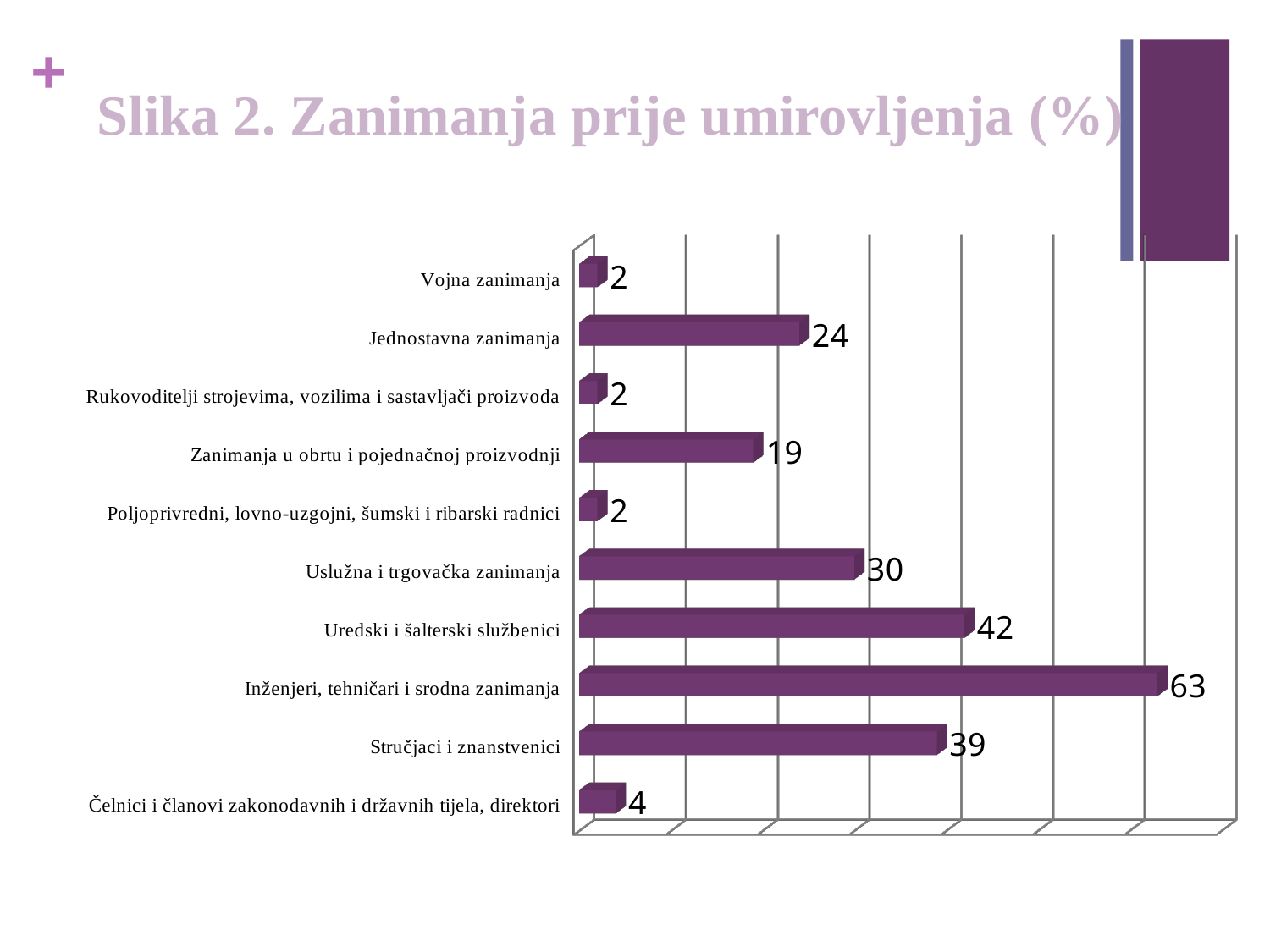
What kind of chart is shown on the slide? Bar chart What is the value for Inženjeri, tehničari i srodna zanimanja? 63 Which is larger, the value for Zanimanja u obrtu i pojednačnoj proizvodnji or the value for Jednostavna zanimanja? Jednostavna zanimanja How many categories are shown in the chart? 10 What is the value for Čelnici i članovi zakonodavnih i državnih tijela, direktori? 4 What is the difference between the values for Inženjeri, tehničari i srodna zanimanja and Stručjaci i znanstvenici? 24 What is the title of the chart? Slika 2. Zanimanja prije umirovljenja (%) How many categories have a value of 2? 3 What is the difference between the values for Uredski i šalterski službenici and Jednostavna zanimanja? 18 What is the value for Stručjaci i znanstvenici? 39 What is the value for Uslužna i trgovačka zanimanja? 30 Which category has the highest value? Inženjeri, tehničari i srodna zanimanja